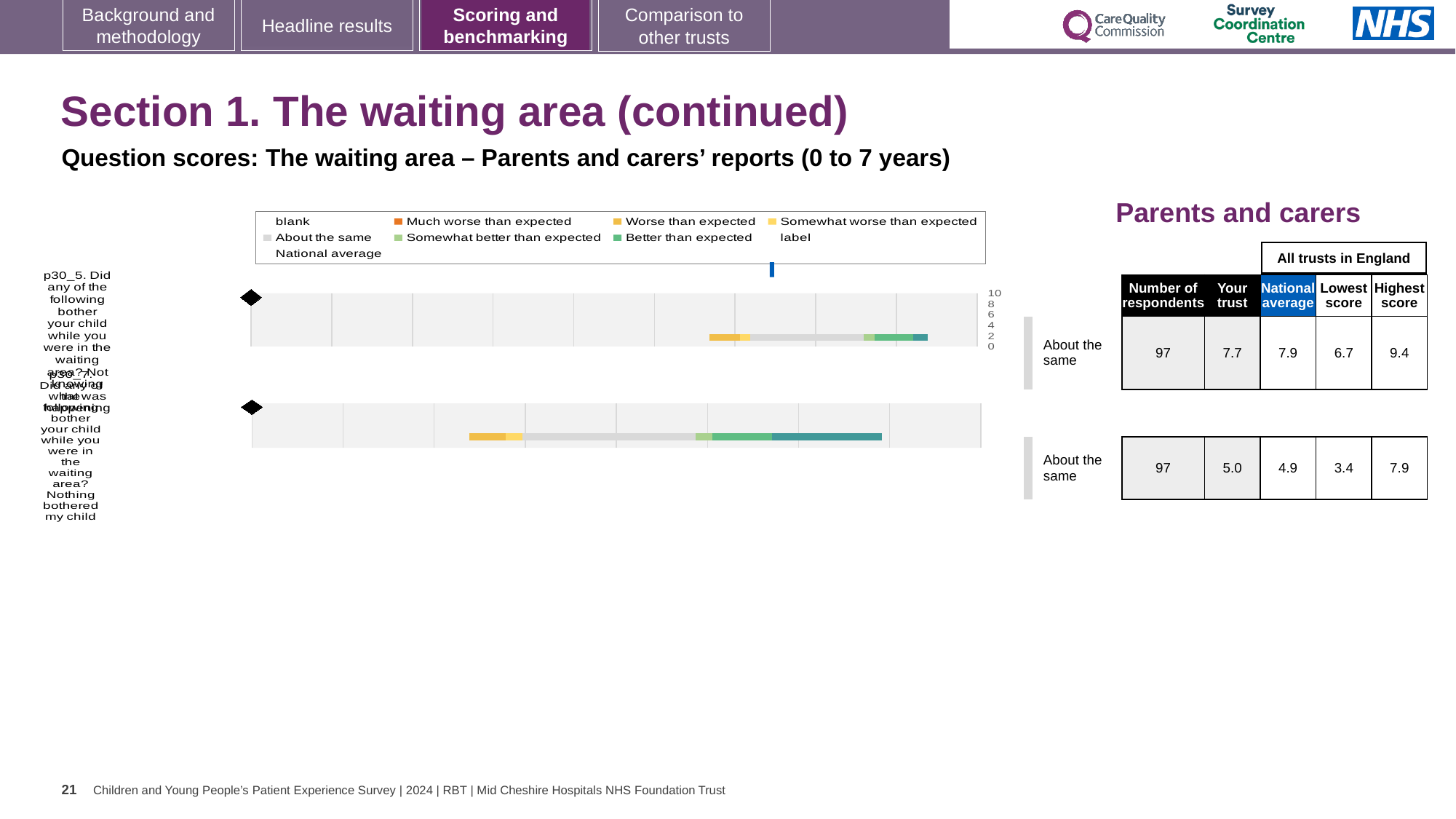
What kind of chart is used on this slide to show the question scores? bar chart For the bottom chart (p30_7), what is the lowest score among all trusts in England shown in the table? 3.4 What is the highest value shown on the chart's horizontal axis? 10 For the bottom chart (p30_7), what is the "Your trust" score shown in the table? 5.0 How many charts are shown on the slide? 2 In the chart legend, what colour represents "Much worse than expected"? orange For the top chart (p30_5), how many respondents are shown in the table? 97 For the top chart (p30_5), what is the difference between the highest score and the lowest score shown in the table? 2.7 For the top chart (p30_5), which is larger: the "Your trust" score or the national average? National average For the top chart (p30_5), what is the "Your trust" score shown in the table? 7.7 For the top chart (p30_5), what is the national average score shown in the table? 7.9 How many entries does the chart legend list? 9